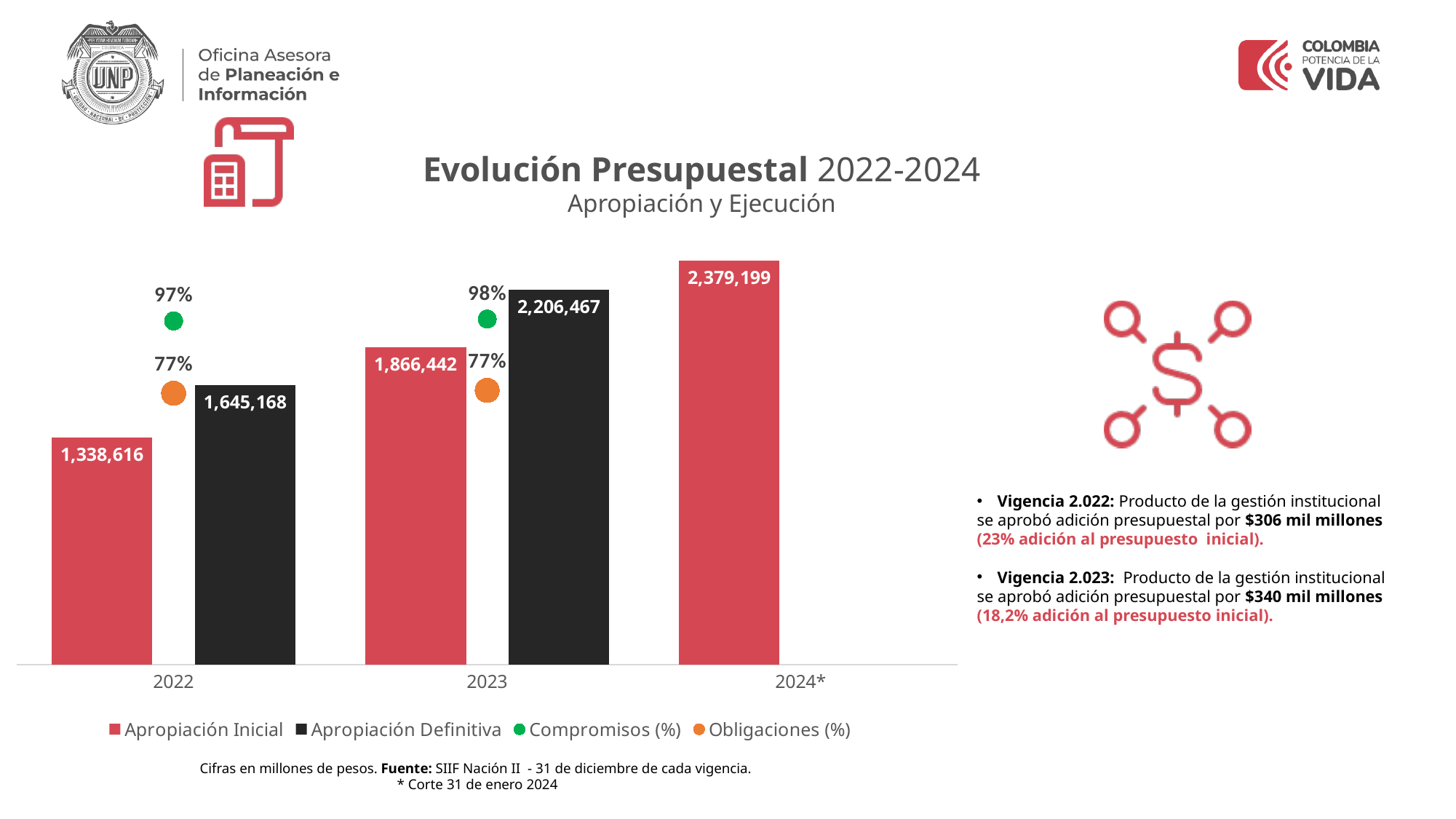
What is the Apropiación Inicial value for 2024*? 2,379,199 What is the Apropiación Definitiva value for 2023? 2,206,467 What is the Compromisos (%) value for 2023? 98% Does the Apropiación Inicial rise or fall from 2022 to 2024*? rise What is the difference between Apropiación Definitiva and Apropiación Inicial in 2022? 306,552 What is the Apropiación Inicial value for 2022? 1,338,616 What is the difference between Apropiación Definitiva and Apropiación Inicial in 2023? 340,025 What is the Obligaciones (%) value for 2022? 77% Which is larger, the Apropiación Definitiva for 2022 or the Apropiación Inicial for 2023? Apropiación Inicial for 2023 How many series does the legend list? 4 Which year has the highest Apropiación Inicial? 2024* Which year has the lowest Apropiación Inicial? 2022